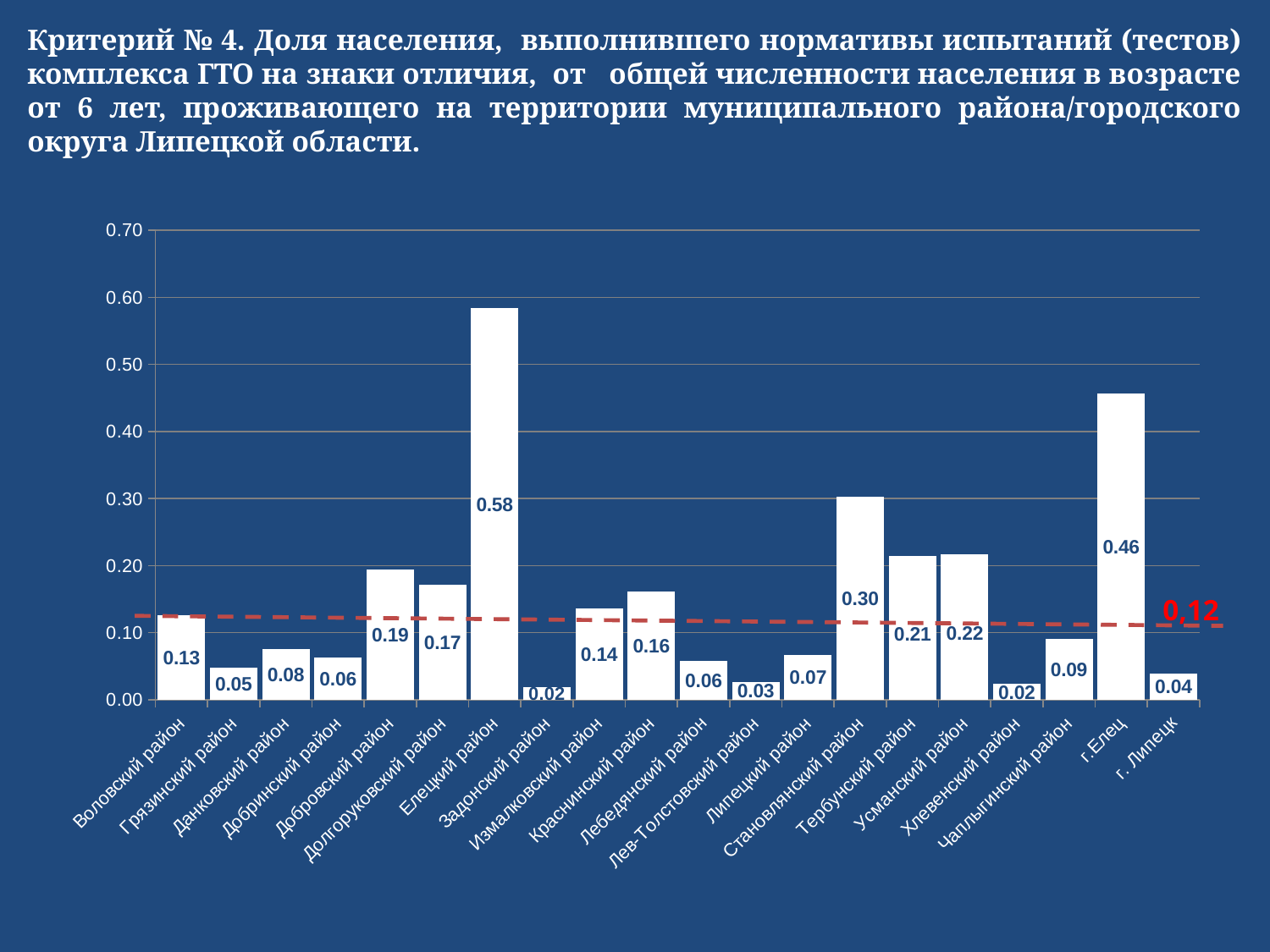
What is the value for Елецкий район? 0.58 What is the value for г.Елец? 0.46 What is the difference between the values for Елецкий район and г.Елец? 0.12 How many categories are shown on the x axis? 20 What is the difference between the values for Усманский район and Тербунский район? 0.01 Which is larger, the value for Добровский район or the value for Долгоруковский район? Добровский район What value does the red dashed horizontal line mark? 0.12 What is the value for г. Липецк? 0.04 Is the value for Становлянский район greater or less than 0.20? greater What is the value for Становлянский район? 0.30 What kind of chart is shown on the slide? bar chart Which category has the highest value? Елецкий район